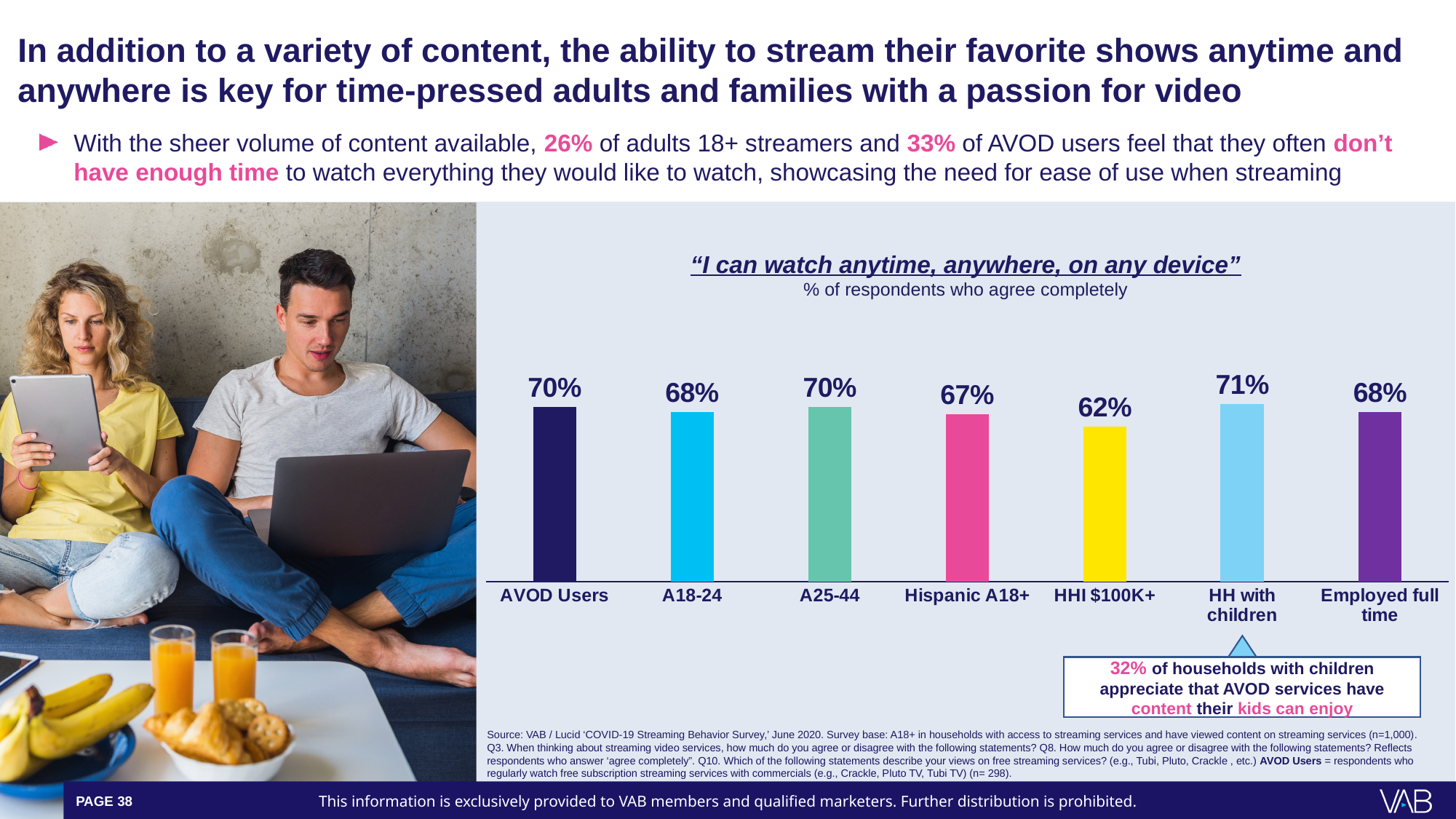
What is the title of the chart? "I can watch anytime, anywhere, on any device" What kind of chart is shown on the slide? Bar chart What is the value shown for Hispanic A18+? 67% Which category has the highest value in the chart? HH with children What does the chart subtitle say the values represent? % of respondents who agree completely What is the difference between the values for AVOD Users and Employed full time? 2 percentage points Which category has the lowest value in the chart? HHI $100K+ What is the difference between the values for HH with children and HHI $100K+? 9 percentage points What percentage of AVOD Users agree completely that they can watch anytime, anywhere, on any device? 70% How many categories are shown in the chart? 7 Which is larger, the value for A25-44 or the value for A18-24? A25-44 What is the value shown for HHI $100K+? 62%